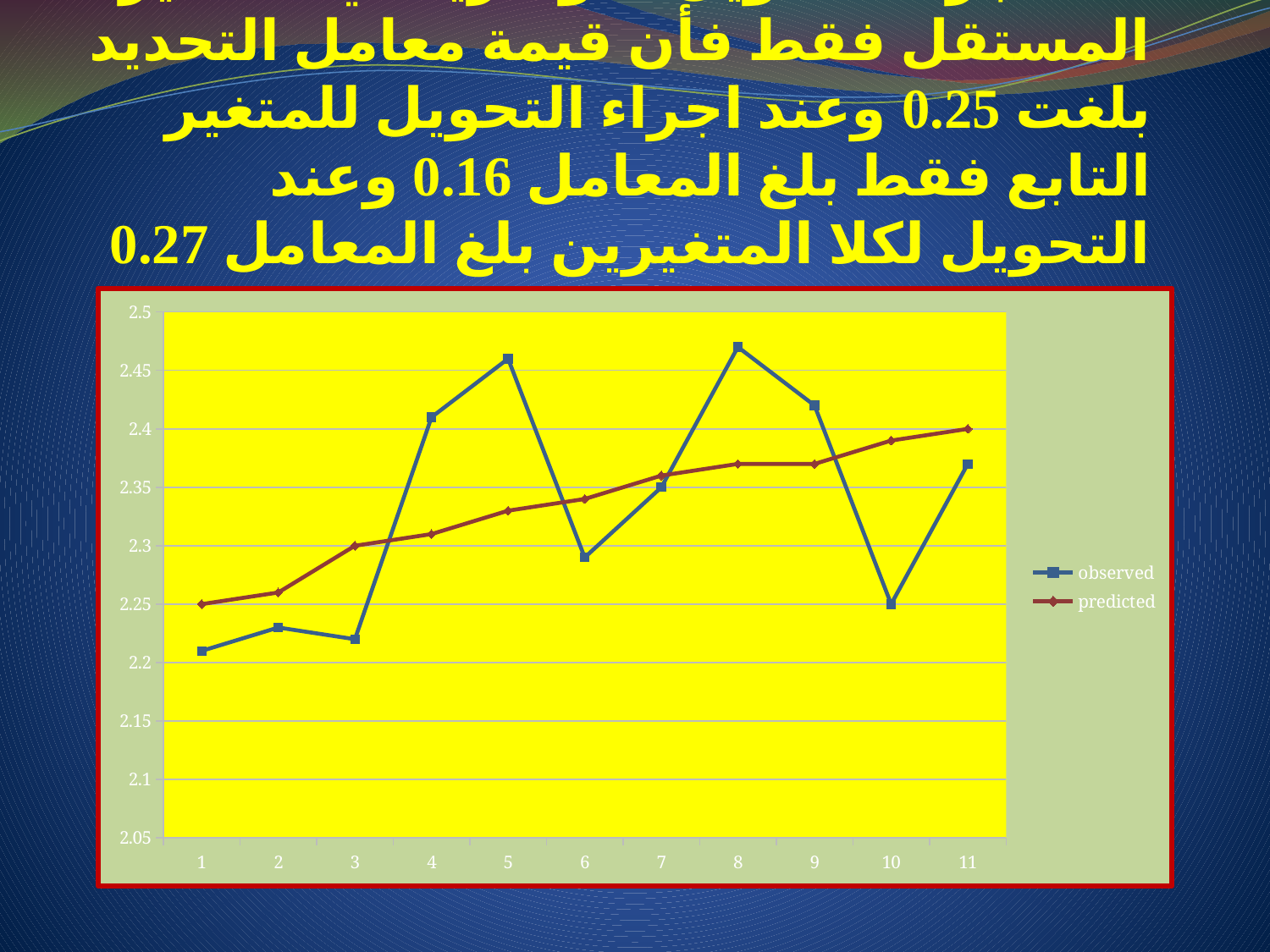
At which x-axis point is the predicted series lowest? 1 What are the names of the two series in the legend? observed and predicted What is the predicted value at point 1? 2.25 At which x-axis point is the predicted series highest? 11 How many points are plotted along the x axis for each series? 11 Is the observed value at point 8 greater or less than 2.45? greater What is the predicted value at point 11? 2.4 Does the predicted series rise or fall from point 1 to point 11? rise What kind of chart is shown on the slide? line chart How many series does the chart legend list? 2 At point 10, which series has the higher value, observed or predicted? predicted